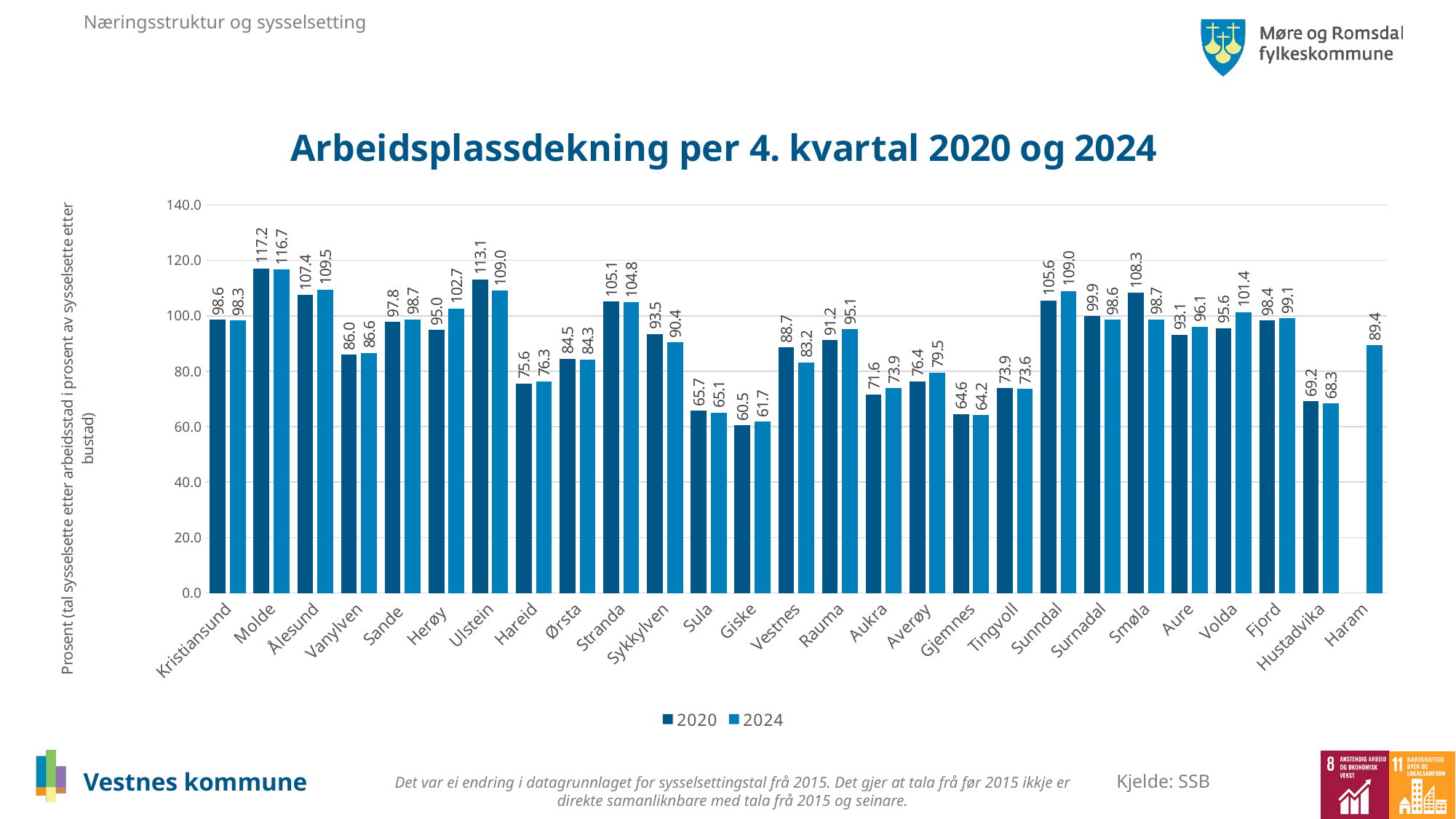
Which municipality has the lowest 2024 value? Giske What is the title of the chart? Arbeidsplassdekning per 4. kvartal 2020 og 2024 What is the 2024 value for Vestnes? 83.2 Which municipality has the highest 2020 value? Molde What is the 2024 value for Haram? 89.4 How many municipalities are shown on the x axis? 27 What is the 2020 value for Ulstein? 113.1 Is the 2020 value for Sunndal greater or less than 100? greater What kind of chart is shown on the slide? Bar chart What is the difference between the 2020 and 2024 values for Smøla? 9.6 Which is larger for Herøy, the 2020 value or the 2024 value? 2024 How many series does the legend list? 2